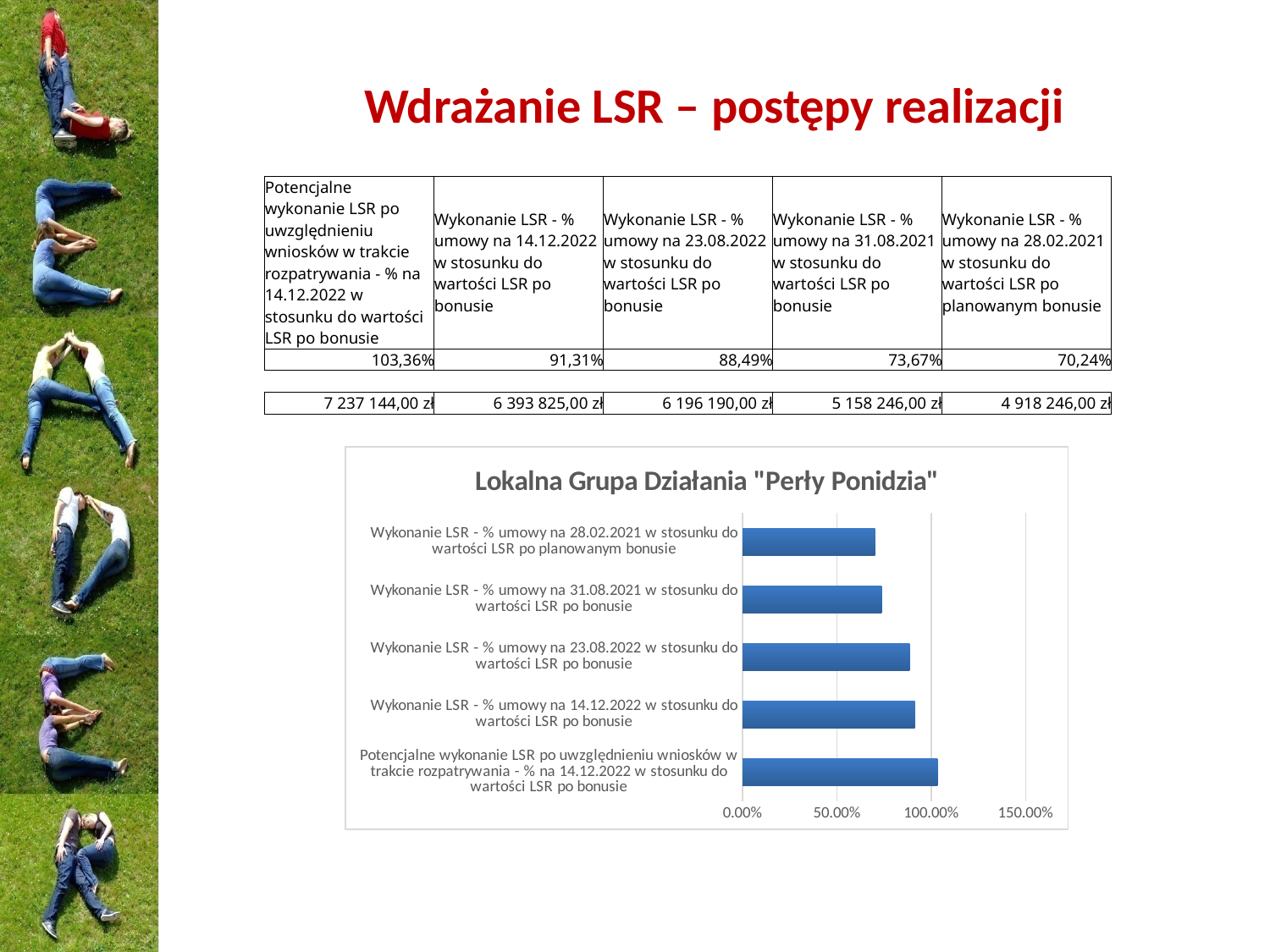
Which is larger: the bar for "Wykonanie LSR - % umowy na 14.12.2022 w stosunku do wartości LSR po bonusie" or the bar for "Wykonanie LSR - % umowy na 31.08.2021 w stosunku do wartości LSR po bonusie"? Wykonanie LSR - % umowy na 14.12.2022 w stosunku do wartości LSR po bonusie According to the table on the slide, what is the value of "Wykonanie LSR - % umowy na 28.02.2021 w stosunku do wartości LSR po planowanym bonusie"? 70,24% Which category has the shortest bar in the chart? Wykonanie LSR - % umowy na 28.02.2021 w stosunku do wartości LSR po planowanym bonusie According to the table on the slide, what is the value of "Wykonanie LSR - % umowy na 14.12.2022 w stosunku do wartości LSR po bonusie"? 91,31% Is the value for "Wykonanie LSR - % umowy na 31.08.2021 w stosunku do wartości LSR po bonusie" greater or less than 50.00%? greater Is the value for "Potencjalne wykonanie LSR po uwzględnieniu wniosków w trakcie rozpatrywania - % na 14.12.2022 w stosunku do wartości LSR po bonusie" greater or less than 100.00%? greater What is the highest tick value shown on the chart's horizontal axis? 150.00% Is the value for "Wykonanie LSR - % umowy na 28.02.2021 w stosunku do wartości LSR po planowanym bonusie" greater or less than 100.00%? less How many bars does the chart have? 5 What is the title of the chart? Lokalna Grupa Działania "Perły Ponidzia" What kind of chart is shown on the slide? bar chart Which category has the longest bar in the chart? Potencjalne wykonanie LSR po uwzględnieniu wniosków w trakcie rozpatrywania - % na 14.12.2022 w stosunku do wartości LSR po bonusie